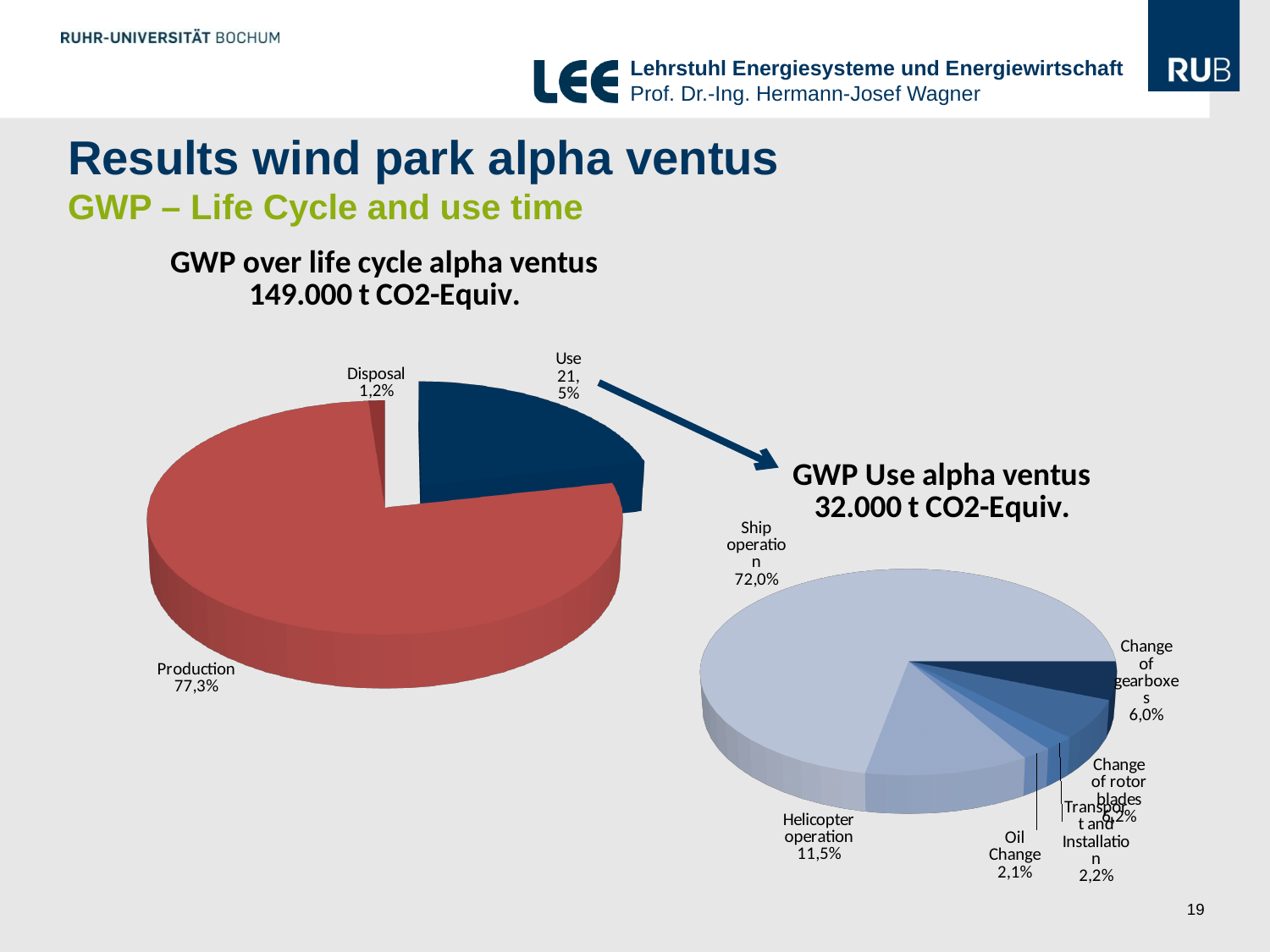
In the 'GWP Use alpha ventus' pie chart, which slice is the smallest? Oil Change What kind of chart is the 'GWP Use alpha ventus' chart? Pie chart In the 'GWP over life cycle alpha ventus' pie chart, which slice is the smallest? Disposal In the 'GWP Use alpha ventus' pie chart, what share does Helicopter operation have? 11,5% In the 'GWP over life cycle alpha ventus' pie chart, how many slices are there? 3 In the 'GWP over life cycle alpha ventus' pie chart, what share does Production have? 77,3% In the 'GWP Use alpha ventus' pie chart, what share does Ship operation have? 72,0% In the 'GWP over life cycle alpha ventus' pie chart, which slice is the largest? Production In the 'GWP over life cycle alpha ventus' pie chart, what share does Disposal have? 1,2% In the 'GWP over life cycle alpha ventus' pie chart, what share does Use have? 21,5% In the 'GWP Use alpha ventus' pie chart, which is larger: Change of gearboxes or Oil Change? Change of gearboxes What total value is stated in the title of the 'GWP Use alpha ventus' chart? 32.000 t CO2-Equiv.